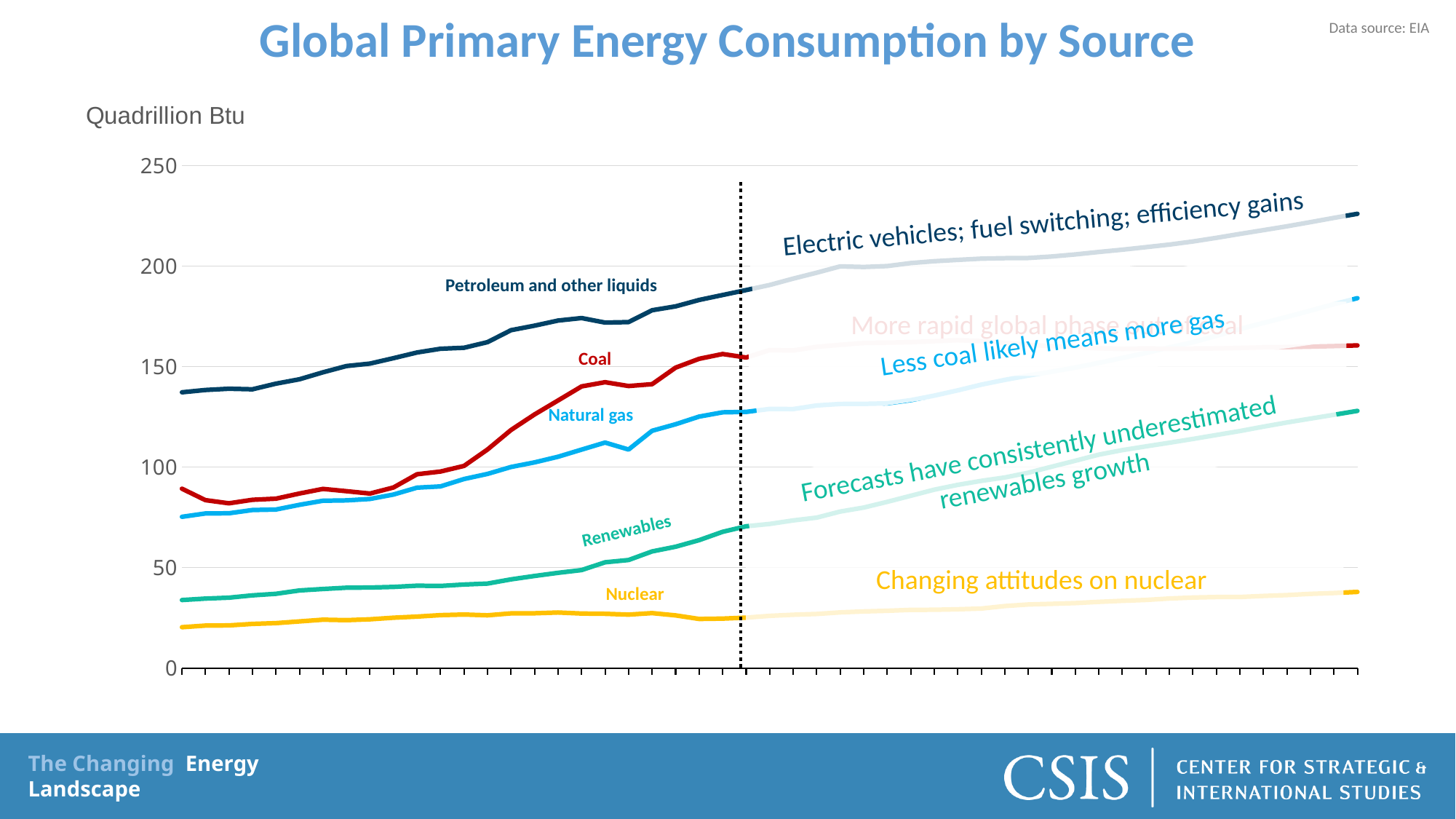
Which energy source has the lowest consumption across the chart? Nuclear In what unit are the values on the chart measured? Quadrillion Btu Is the value for Petroleum and other liquids at the dotted vertical line greater or less than 150? greater How many energy source series are plotted on the chart? 5 At the right end of the chart, which is larger: Natural gas or Coal? Natural gas Which energy source has the highest consumption across the chart? Petroleum and other liquids Does the Renewables line rise or fall from left to right? Rise Is the value for Nuclear at the right end of the chart greater or less than 50? less What is the title of the chart? Global Primary Energy Consumption by Source Is the value for Renewables at the dotted vertical line greater or less than 100? less What kind of chart is shown on the slide? Line chart At the dotted vertical line, which is larger: Coal or Natural gas? Coal